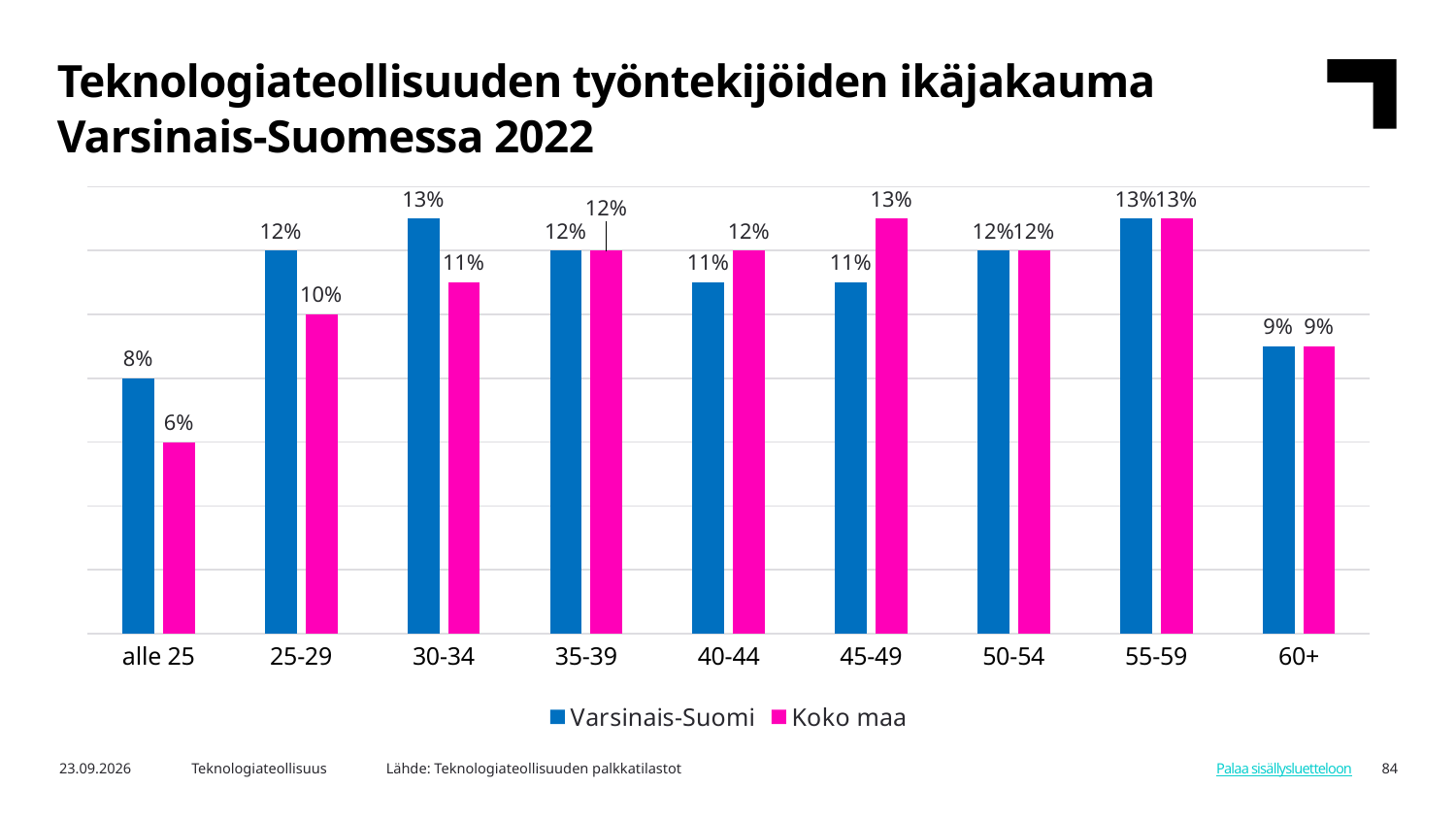
What is the Varsinais-Suomi value for the 45-49 age group? 11% What kind of chart is shown on the slide? Bar chart For the 45-49 age group, which series has the larger value, Varsinais-Suomi or Koko maa? Koko maa Which age group has the lowest Varsinais-Suomi value? alle 25 What is the Koko maa value for the 60+ age group? 9% Which age group has the lowest Koko maa value? alle 25 What is the Varsinais-Suomi value for the alle 25 age group? 8% What is the Koko maa value for the 25-29 age group? 10% How many age groups are shown on the x axis? 9 For the 30-34 age group, which series has the larger value, Varsinais-Suomi or Koko maa? Varsinais-Suomi How many series does the legend list? 2 What is the difference between the Varsinais-Suomi and Koko maa values for the alle 25 age group? 2 percentage points